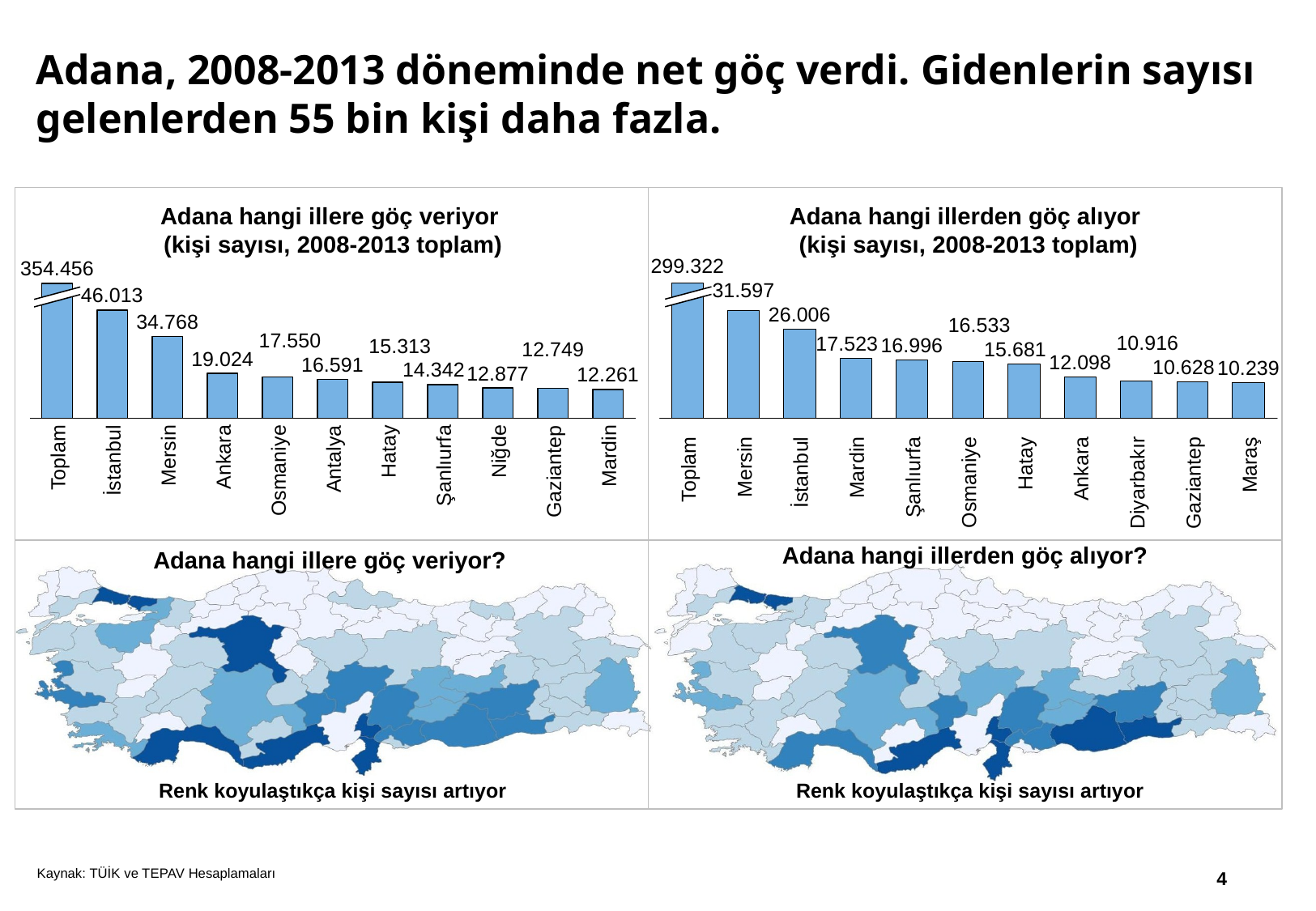
In the chart 'Adana hangi illerden göç alıyor', what is the value for Diyarbakır? 10.916 In the chart 'Adana hangi illere göç veriyor', what is the value for Mardin? 12.261 What kind of chart is 'Adana hangi illerden göç alıyor'? Bar chart In the chart 'Adana hangi illere göç veriyor', which province (excluding Toplam) has the highest value? İstanbul In the chart 'Adana hangi illerden göç alıyor', which is larger, the value for Mardin or the value for Hatay? Mardin In the chart 'Adana hangi illerden göç alıyor', which category has the lowest value? Maraş In the chart 'Adana hangi illere göç veriyor', what is the difference between the values for İstanbul and Mersin? 11.245 What is the difference between the Toplam value in 'Adana hangi illere göç veriyor' and the Toplam value in 'Adana hangi illerden göç alıyor'? 55.134 How many categories are shown in the chart 'Adana hangi illere göç veriyor'? 11 In the chart 'Adana hangi illere göç veriyor', what is the value for İstanbul? 46.013 In the chart 'Adana hangi illerden göç alıyor', what is the value for Mersin? 31.597 In the chart 'Adana hangi illerden göç alıyor', do the values rise or fall from left to right along the x axis? Fall